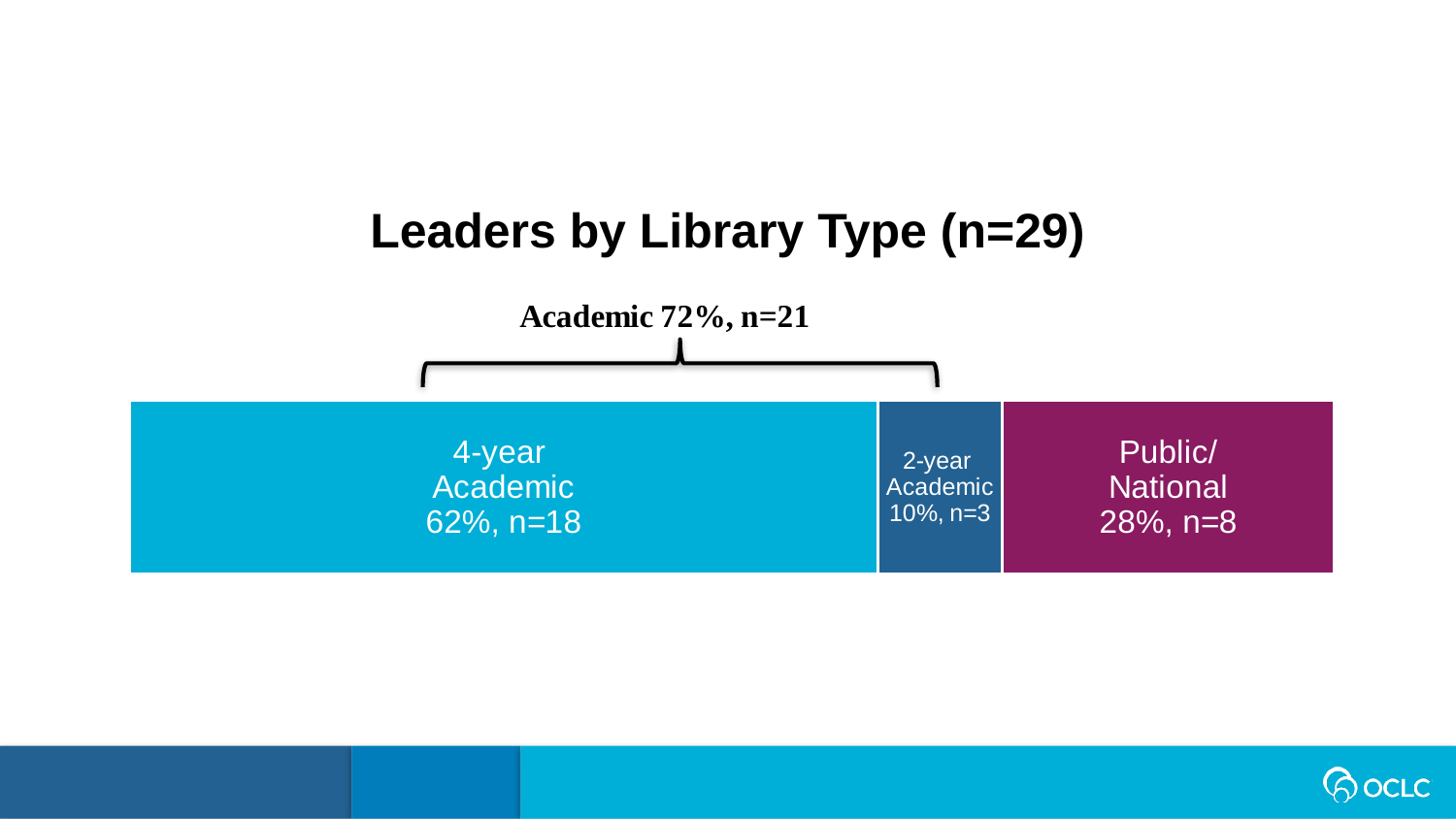
What is the title of the chart? Leaders by Library Type (n=29) Which library type has the largest share of leaders? 4-year Academic What is the difference in percentage points between 4-year Academic and Public/National? 34 Which is larger, the share for Public/National or the share for 2-year Academic? Public/National How many leaders (n) are from 2-year Academic libraries? 3 What percentage of leaders are from Public/National libraries? 28% How many library type segments are shown in the bar? 3 What percentage of leaders are from 4-year Academic libraries? 62% Which library type has the smallest share of leaders? 2-year Academic What combined percentage and count does the bracket label give for Academic libraries? 72%, n=21 What kind of chart is shown on the slide? Stacked bar chart How many leaders (n) are from 4-year Academic libraries? 18